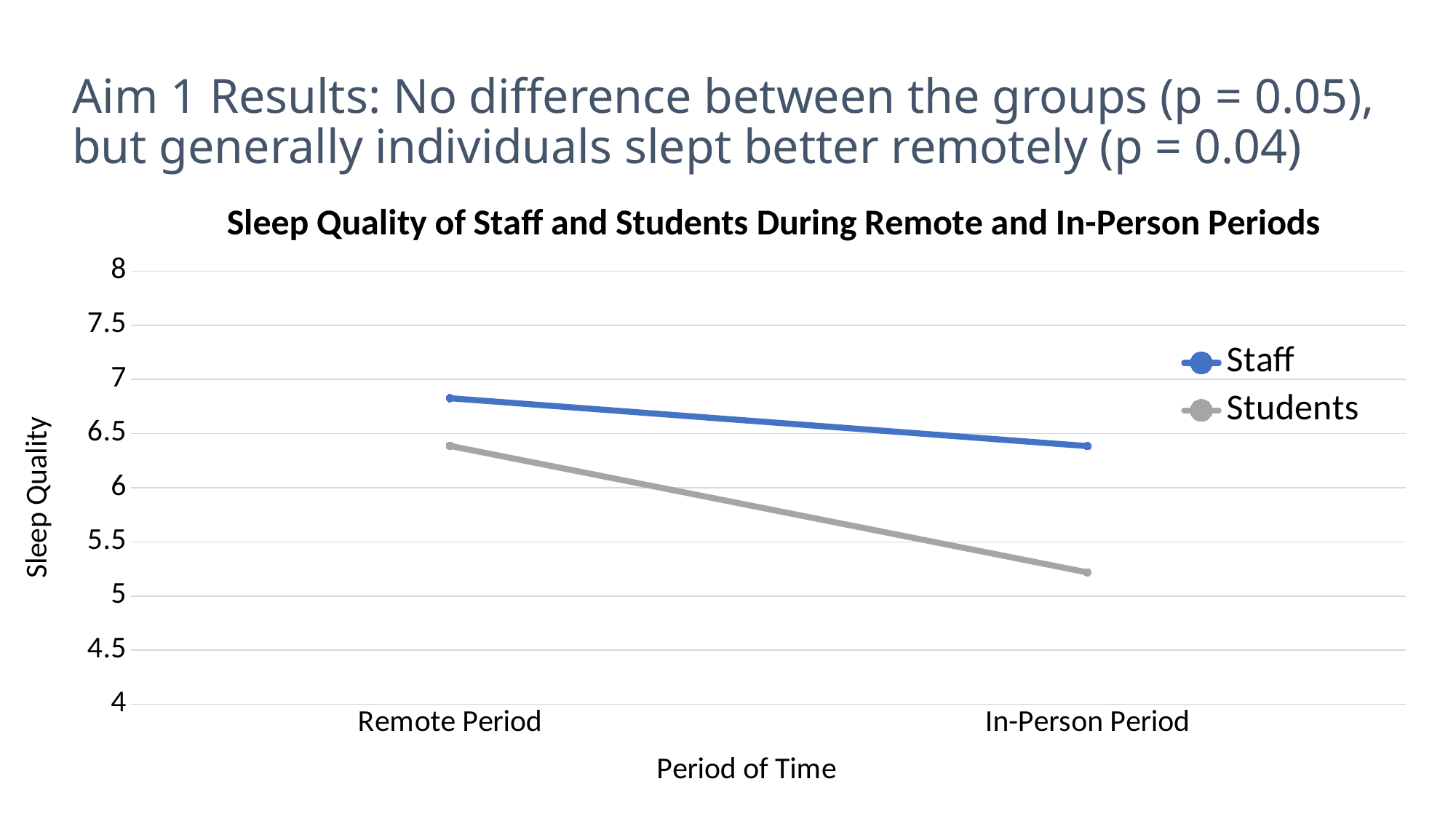
Is the Students value for the In-Person Period greater or less than 5? greater Is the Staff value for the Remote Period greater or less than 6.5? greater In the In-Person Period, which group has the higher sleep quality, Staff or Students? Staff Is the Students value for the In-Person Period greater or less than 5.5? less What is the title of the chart? Sleep Quality of Staff and Students During Remote and In-Person Periods Does the Students line rise or fall from the Remote Period to the In-Person Period? fall Which series and period has the lowest sleep quality on the chart? Students, In-Person Period How many series does the legend list? 2 Which series is drawn in blue? Staff How many periods are shown on the x axis? 2 What kind of chart is shown on the slide? line chart